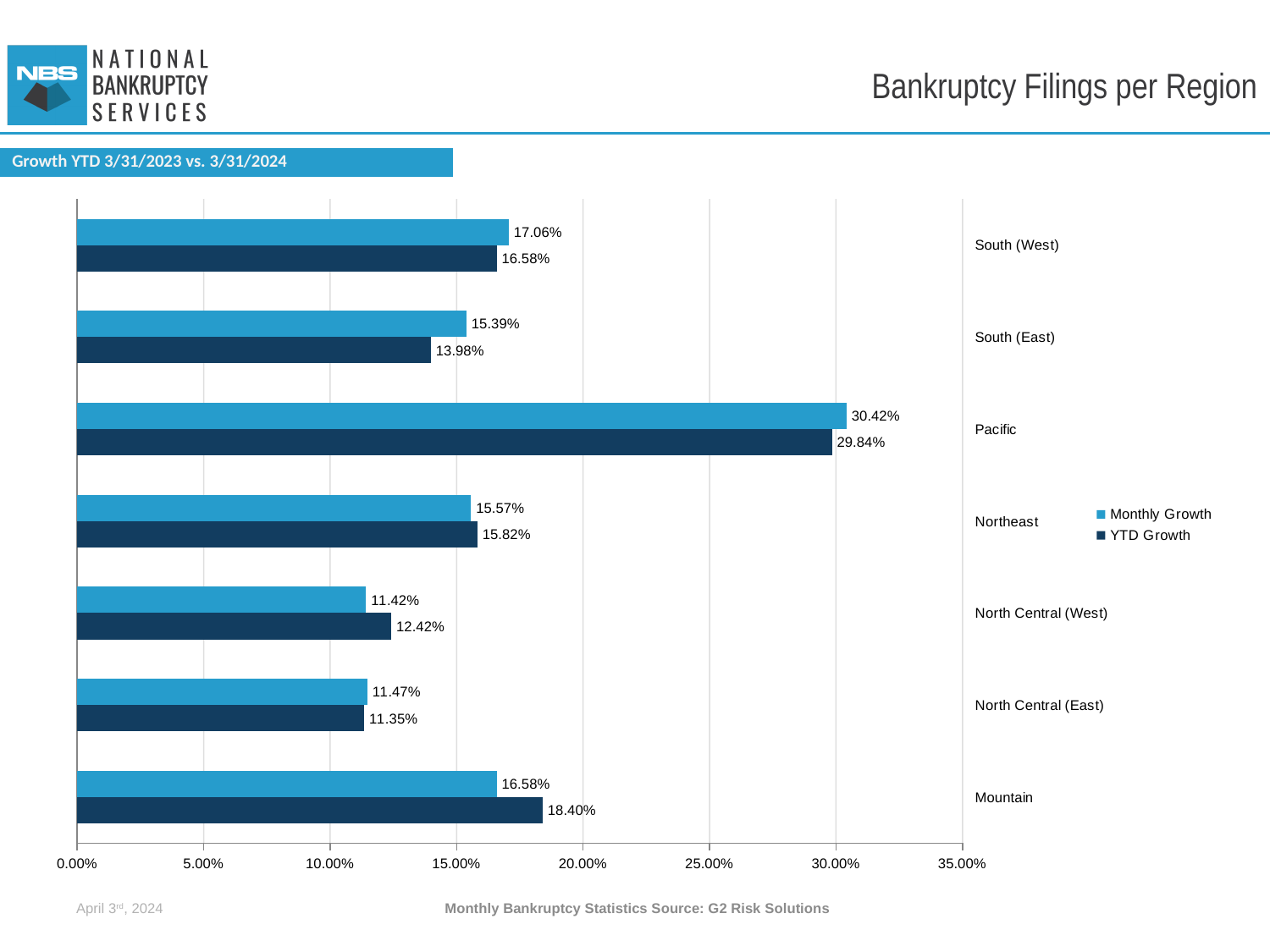
What is the YTD Growth value for Mountain? 18.40% How many regions are shown on the chart? 7 What is the title shown above the chart? Growth YTD 3/31/2023 vs. 3/31/2024 What is the Monthly Growth value for Pacific? 30.42% Which region has the lowest YTD Growth? North Central (East) What kind of chart is shown on the slide? Bar chart Which is larger for Northeast, Monthly Growth or YTD Growth? YTD Growth What is the difference between the Monthly Growth and YTD Growth values for Mountain? 1.82% What is the YTD Growth value for South (East)? 13.98% Which region has the highest Monthly Growth? Pacific Is the YTD Growth value for Pacific greater or less than 25.00%? greater How many series does the legend list? 2